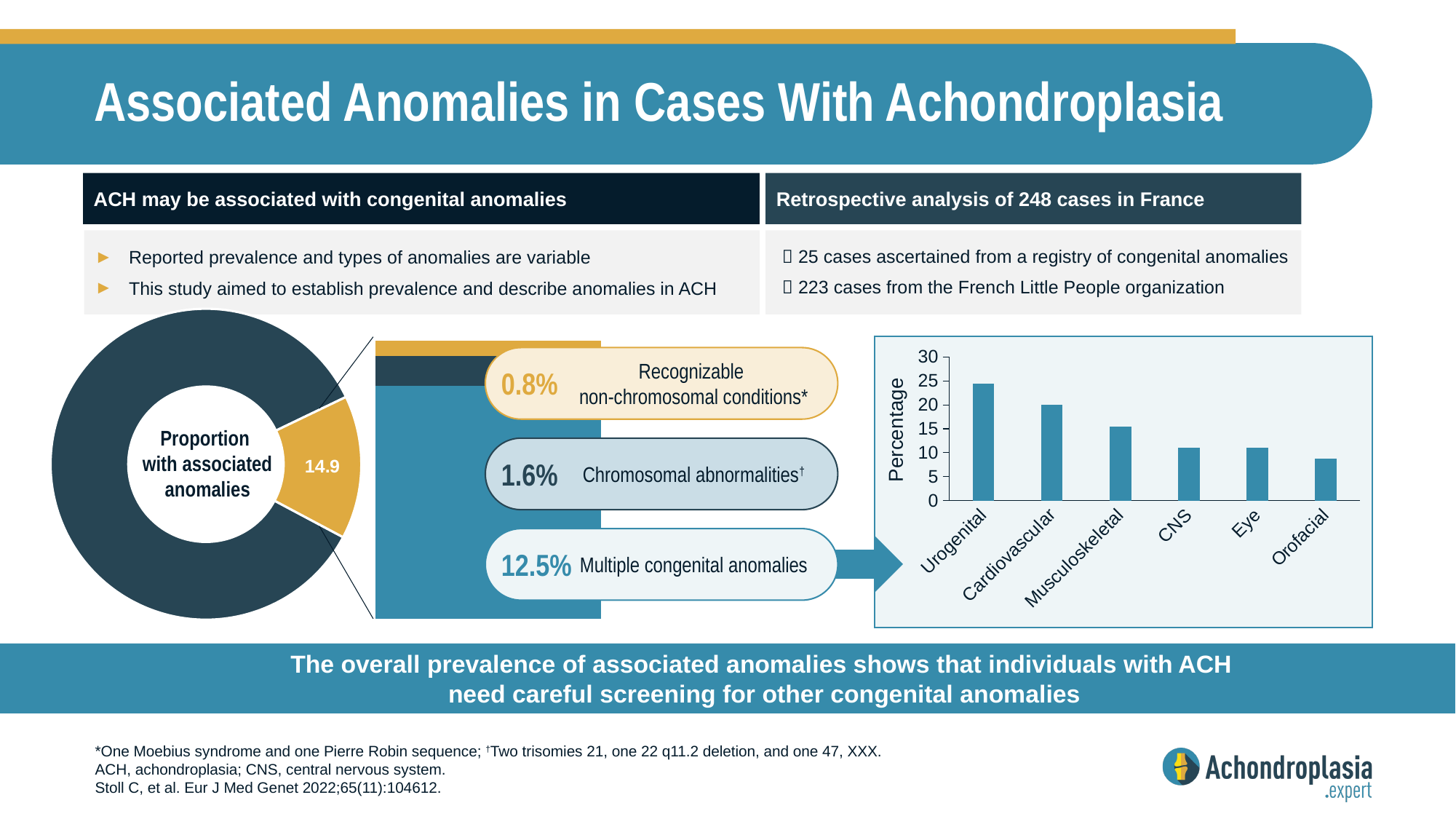
In the bar chart on the right, is the value for Musculoskeletal greater or less than 20? less What kind of chart is the chart on the right with categories Urogenital, Cardiovascular, Musculoskeletal, CNS, Eye and Orofacial? bar chart In the bar chart on the right, which category has the lowest percentage? Orofacial In the bar chart on the right, how many categories are shown on the x axis? 6 In the donut chart on the left, what value is printed on the highlighted gold slice for the proportion with associated anomalies? 14.9 What is the label on the y axis of the bar chart on the right? Percentage In the bar chart on the right, which is larger, the value for Cardiovascular or the value for CNS? Cardiovascular In the bar chart on the right, is the value for Orofacial greater or less than 10? less In the bar chart on the right, do the values generally rise or fall from left to right along the x axis? fall In the bar chart on the right, is the value for Urogenital greater or less than 20? greater In the bar chart on the right, which category has the highest percentage? Urogenital In the stacked bar in the middle of the slide, what percentage is given for multiple congenital anomalies? 12.5%